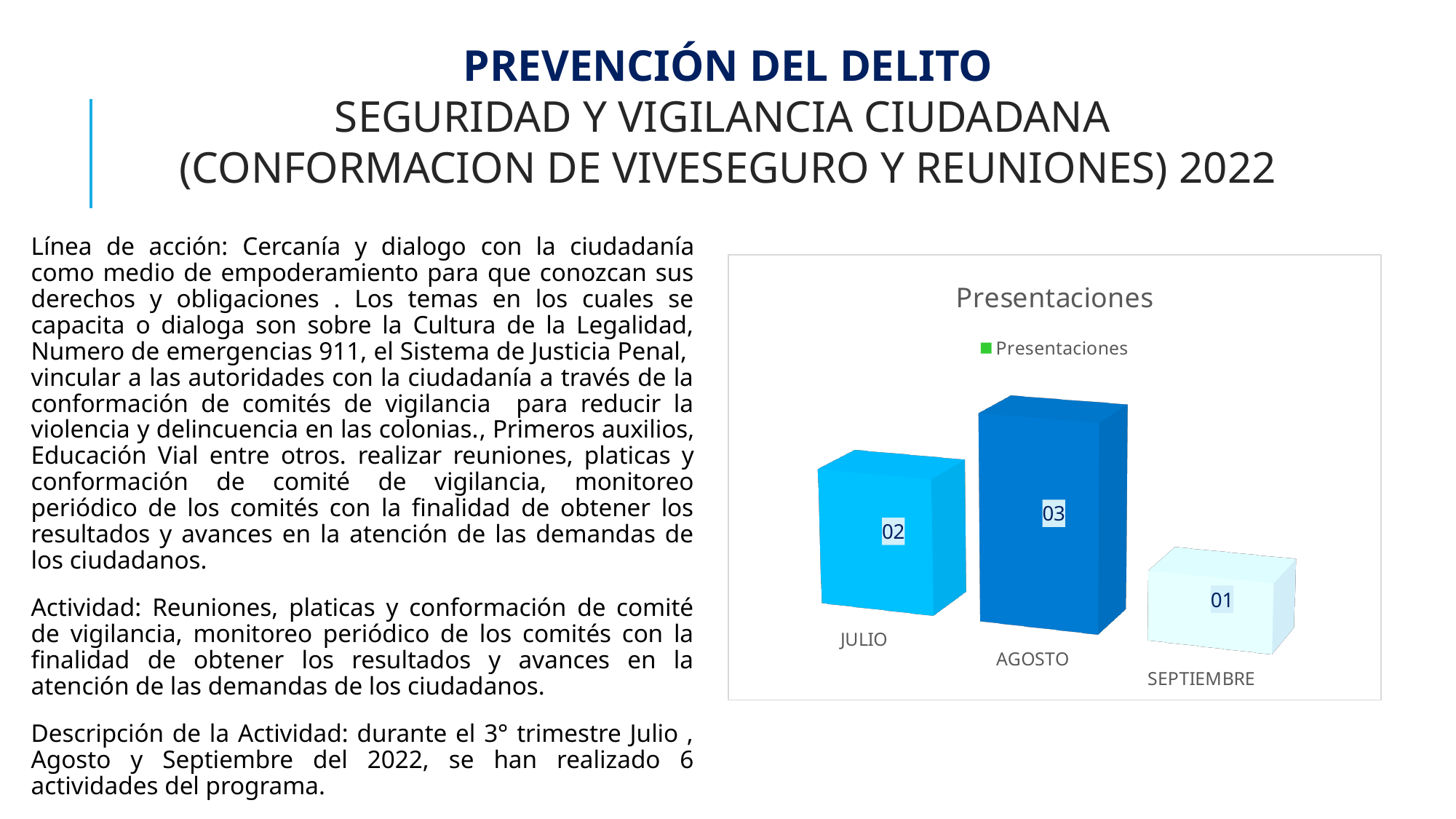
How many categories are shown in the Presentaciones chart? 3 Which month has the highest value in the Presentaciones chart? AGOSTO What is the value for JULIO in the Presentaciones chart? 02 What is the title of the chart on the slide? Presentaciones What is the value for SEPTIEMBRE in the Presentaciones chart? 01 What is the difference between the values for JULIO and SEPTIEMBRE? 1 What is the difference between the values for AGOSTO and SEPTIEMBRE? 2 What is the value for AGOSTO in the Presentaciones chart? 03 How many series does the legend of the Presentaciones chart list? 1 Which is larger, the value for JULIO or the value for AGOSTO? AGOSTO What kind of chart is shown on the slide? Bar chart Which month has the lowest value in the Presentaciones chart? SEPTIEMBRE